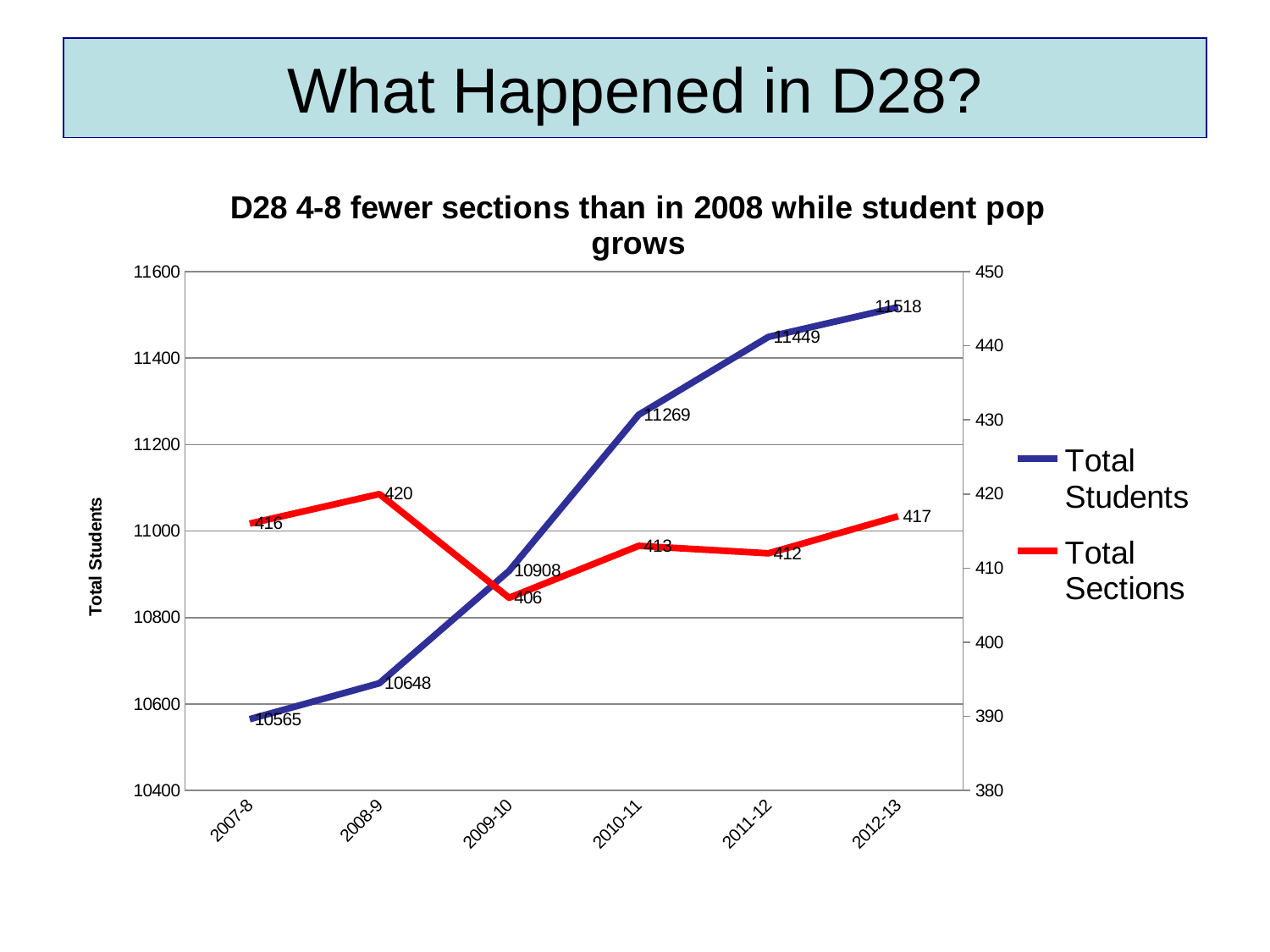
What is the value for Total Sections in 2009-10? 406 How many series does the legend list? 2 How many years are shown on the x axis? 6 In which year is Total Sections lowest? 2009-10 What is the value for Total Students in 2007-8? 10565 What is the difference in Total Sections between 2008-9 and 2012-13? 3 What kind of chart is shown on the slide? Line chart In which year is Total Students highest? 2012-13 What is the difference in Total Students between 2012-13 and 2007-8? 953 What is the value for Total Sections in 2008-9? 420 Which is larger, Total Sections in 2010-11 or in 2011-12? 2010-11 What is the value for Total Students in 2012-13? 11518